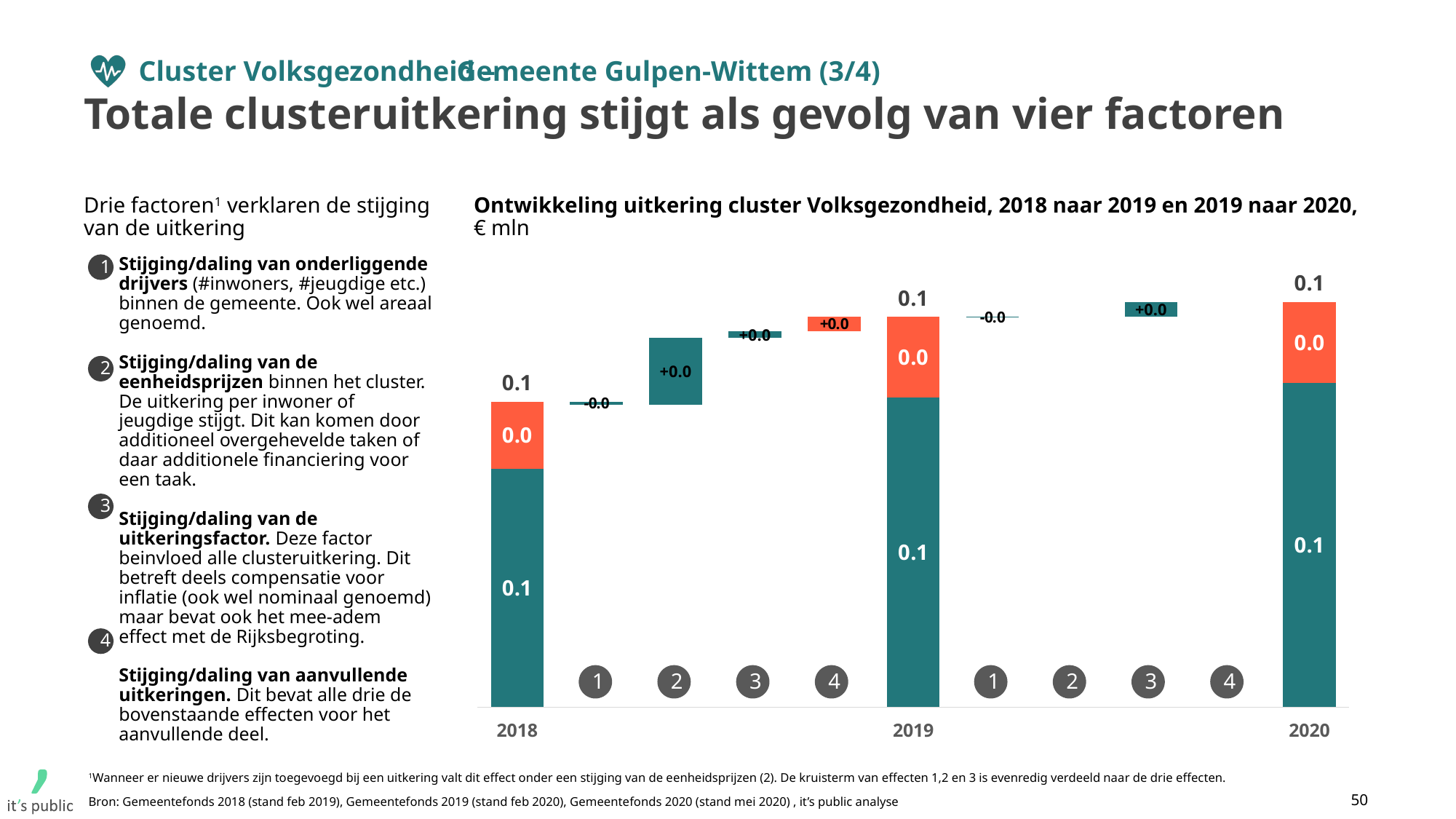
What is the value labelled on step 2 between 2018 and 2019? +0.0 Do the total values above the year bars rise, fall or stay flat from 2018 to 2020? Stay flat How many years are shown as full bars on the x axis? 3 What is the total value shown above the 2018 bar? 0.1 What is the value labelled on step 1 between 2019 and 2020? -0.0 What kind of chart is shown on the slide? Bar chart (waterfall) What is the total value shown above the 2020 bar? 0.1 What is the value of the orange (upper) segment of the 2018 bar? 0.0 How many numbered step bars are shown between 2019 and 2020? 4 What is the value of the teal (lower) segment of the 2019 bar? 0.1 What is the value labelled on step 4 between 2018 and 2019? +0.0 What unit is stated in the chart title? € mln